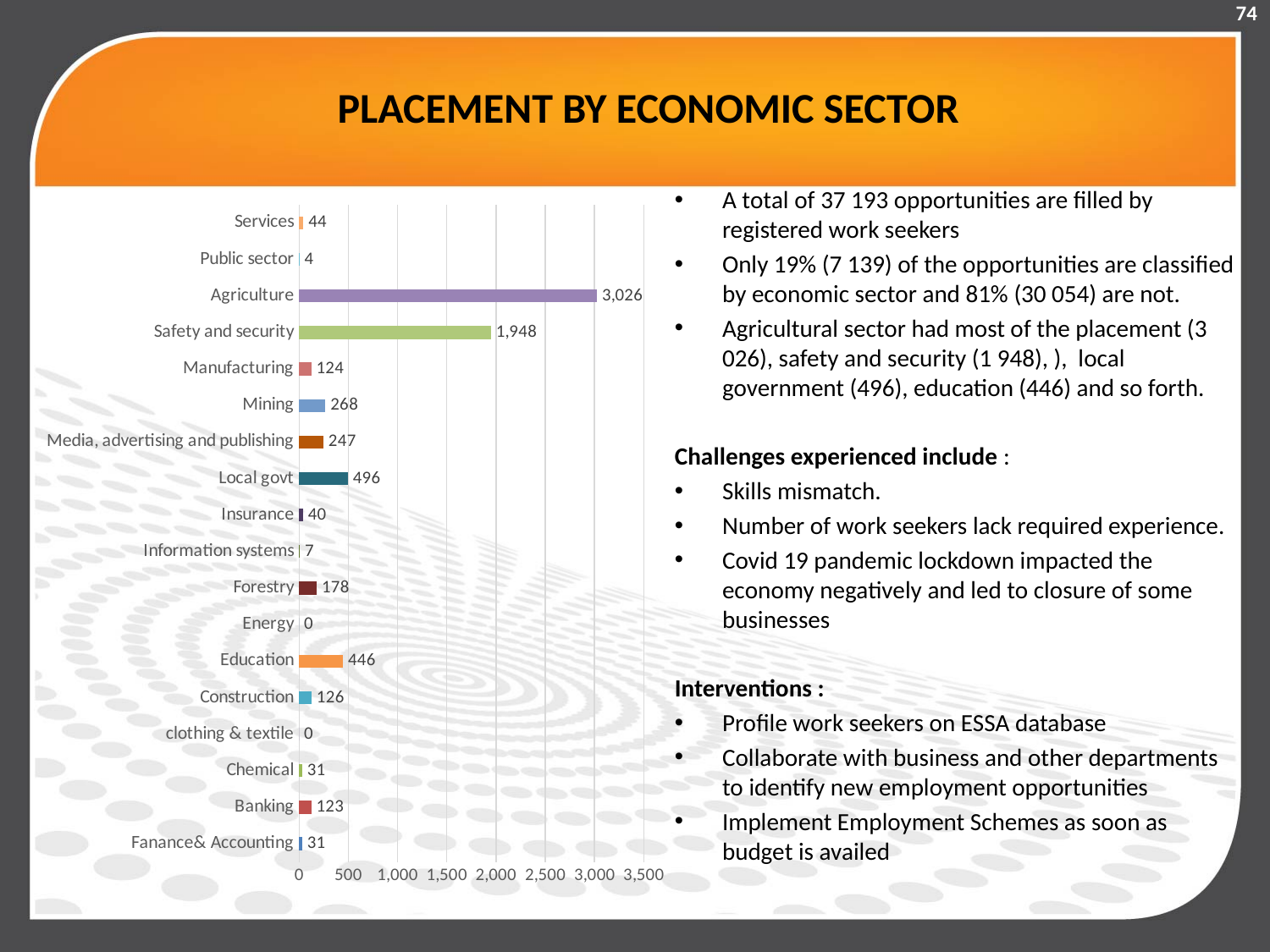
Is the value for Safety and security greater or less than 1,500? greater What is the title of the slide containing the chart? PLACEMENT BY ECONOMIC SECTOR What is the difference between the values for Agriculture and Safety and security? 1,078 Which is larger, the value for Mining or the value for Media, advertising and publishing? Mining What is the value for Public sector? 4 Which category has the highest value? Agriculture What is the value for Agriculture? 3,026 What kind of chart is shown on the slide? Bar chart What is the difference between the values for Education and Local govt? 50 How many categories are shown in the chart? 18 What is the value for Local govt? 496 What is the value for Mining? 268